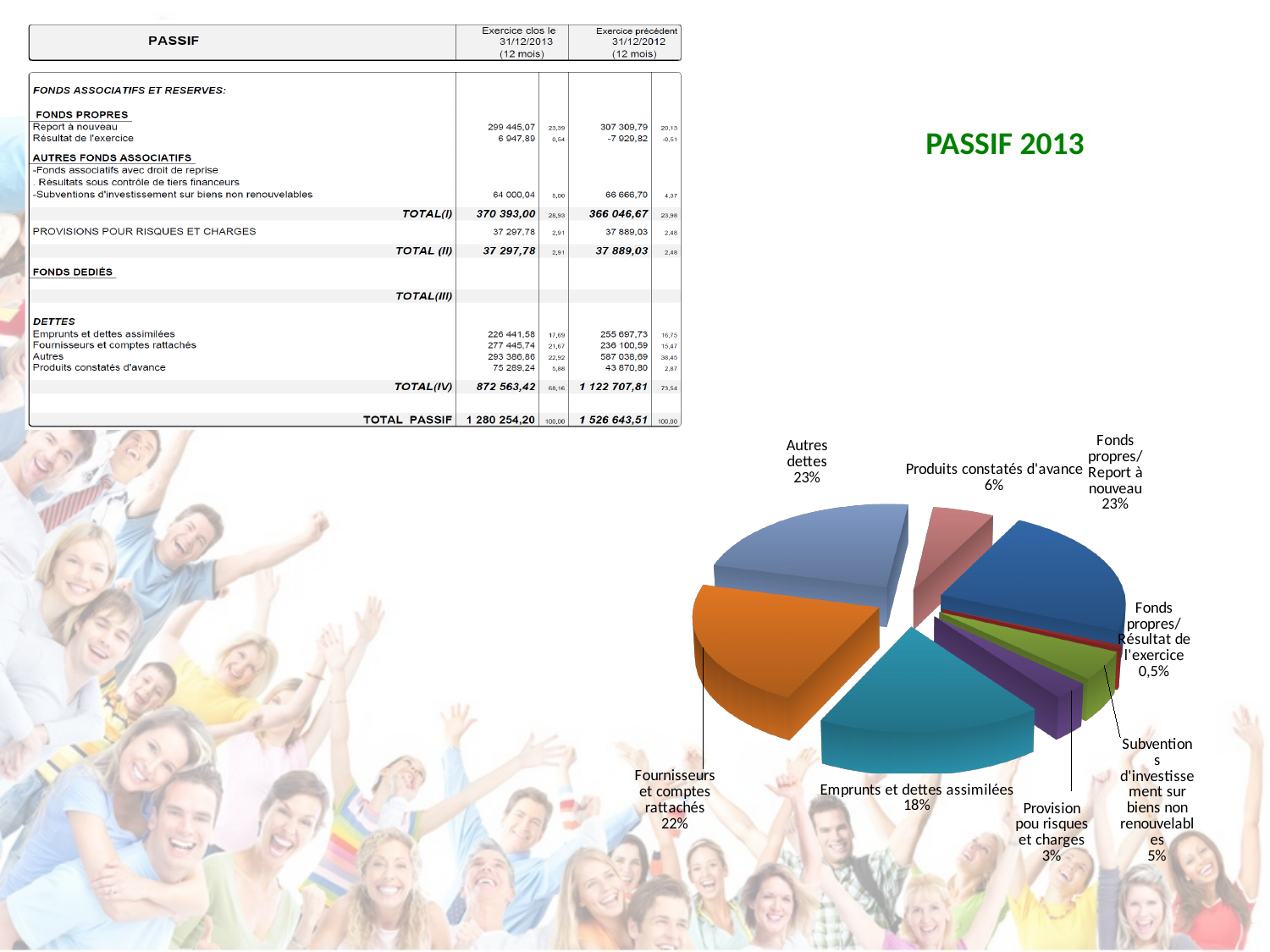
What share of the pie is Produits constatés d'avance? 6% How many slices does the pie chart have? 8 What share of the pie is Fonds propres/Résultat de l'exercice? 0,5% Which is larger: Emprunts et dettes assimilées or Fournisseurs et comptes rattachés? Fournisseurs et comptes rattachés What share of the pie is Fournisseurs et comptes rattachés? 22% What is the title of the chart? PASSIF 2013 What is the difference in percentage points between Autres dettes and Emprunts et dettes assimilées? 5 Which slice is the smallest in the pie chart? Fonds propres/Résultat de l'exercice What kind of chart is shown on the slide? pie chart